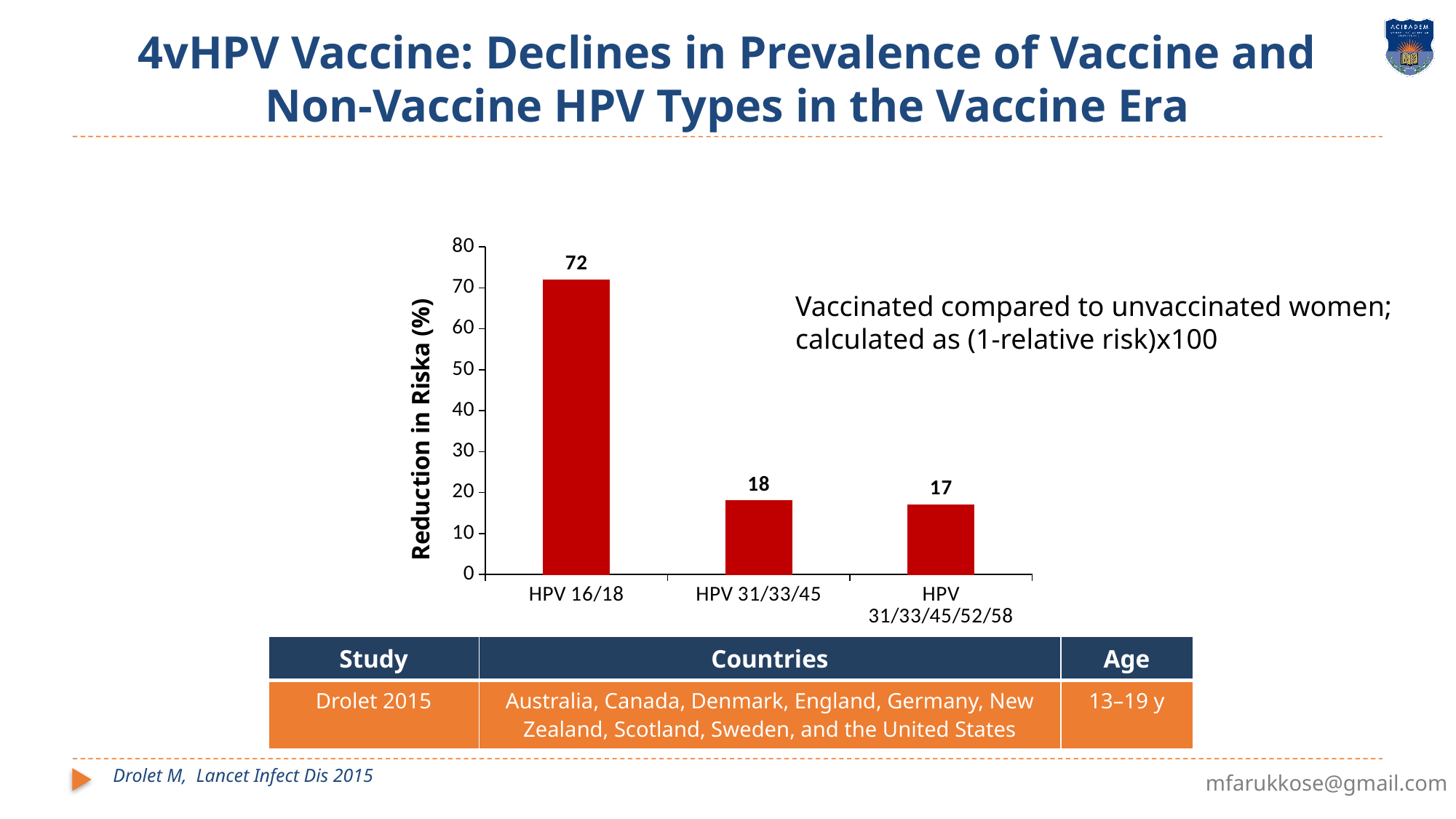
What kind of chart is shown on the slide? bar chart What is the reduction in risk (%) for HPV 31/33/45/52/58? 17 What is the reduction in risk (%) for HPV 31/33/45? 18 What is the difference in reduction in risk between HPV 16/18 and HPV 31/33/45? 54 What is the label of the y axis of the chart? Reduction in Riska (%) What is the reduction in risk (%) for HPV 16/18? 72 Which HPV type group has the lowest reduction in risk? HPV 31/33/45/52/58 What is the difference in reduction in risk between HPV 31/33/45 and HPV 31/33/45/52/58? 1 How many HPV type groups are shown on the chart? 3 Which has a larger reduction in risk, HPV 16/18 or HPV 31/33/45/52/58? HPV 16/18 Which HPV type group has the highest reduction in risk? HPV 16/18 Is the value for HPV 16/18 greater or less than 50? greater